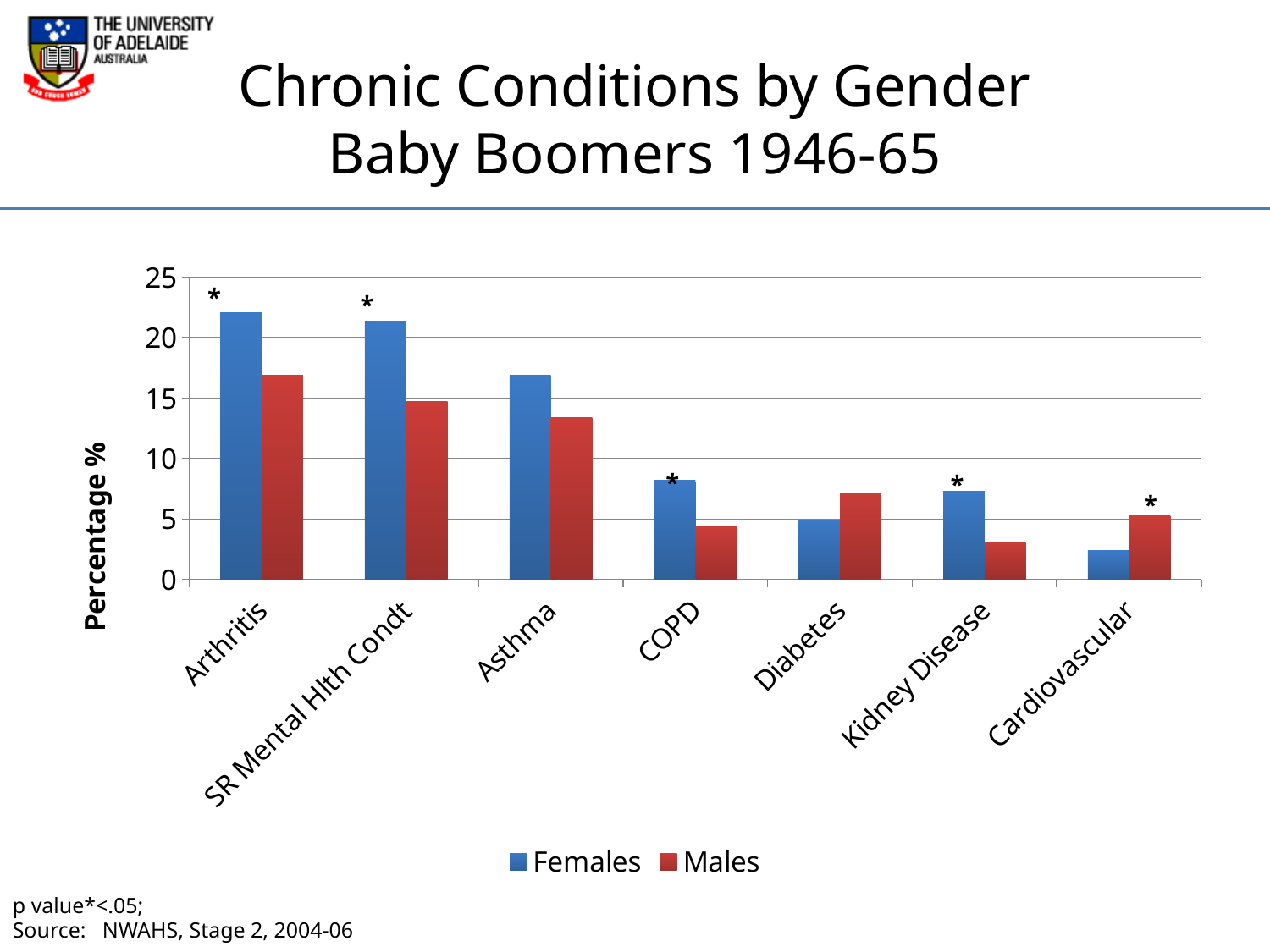
Is the Females value for Arthritis greater or less than 20? greater How many chronic conditions are shown on the x axis? 7 Which condition has the lowest value for Males? Kidney Disease What is the label on the vertical axis? Percentage % How many series does the legend list? 2 For Kidney Disease, which is larger: the Females value or the Males value? Females Is the Females value for Cardiovascular greater or less than 5? less Is the Males value for Asthma greater or less than 15? less For Diabetes, which is larger: the Females value or the Males value? Males Which condition has the highest value for Males? Arthritis Which condition has the lowest value for Females? Cardiovascular What kind of chart is shown on the slide? bar chart